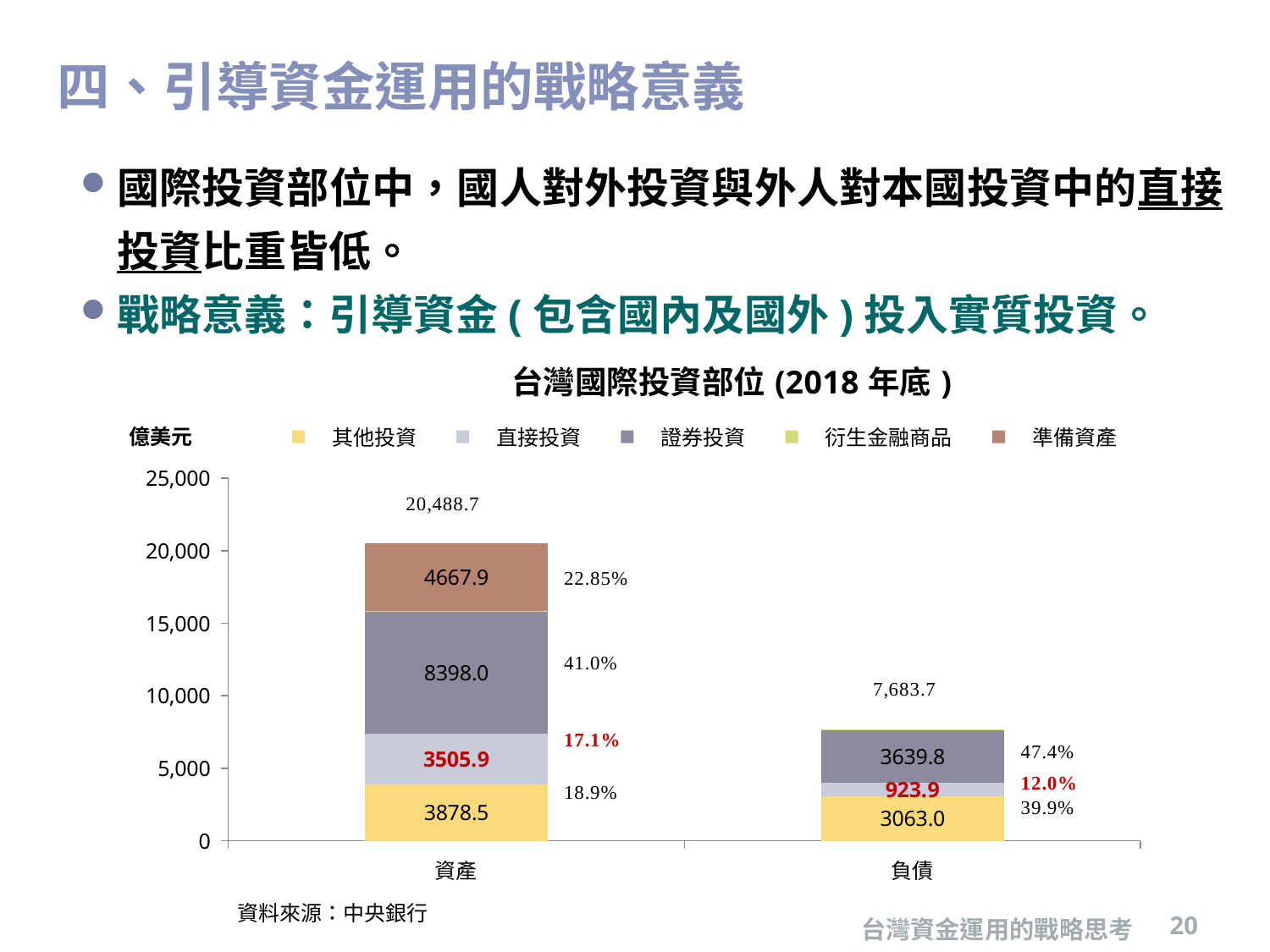
What is the value of 直接投資 in the 負債 bar? 923.9 What is the title of the chart? 台灣國際投資部位 (2018 年底) What is the value of 證券投資 in the 資產 bar? 8398.0 What is the total value of the 負債 bar? 7,683.7 How many categories are shown on the x axis? 2 How many series does the legend list? 5 Is the total for 負債 greater or less than 10,000? less What is the difference between the 其他投資 values for 資產 and 負債? 815.5 What percentage share does 直接投資 have in the 資產 bar? 17.1% Which bar has the larger total, 資產 or 負債? 資產 What is the total value of the 資產 bar? 20,488.7 What type of chart is shown on the slide? stacked bar chart